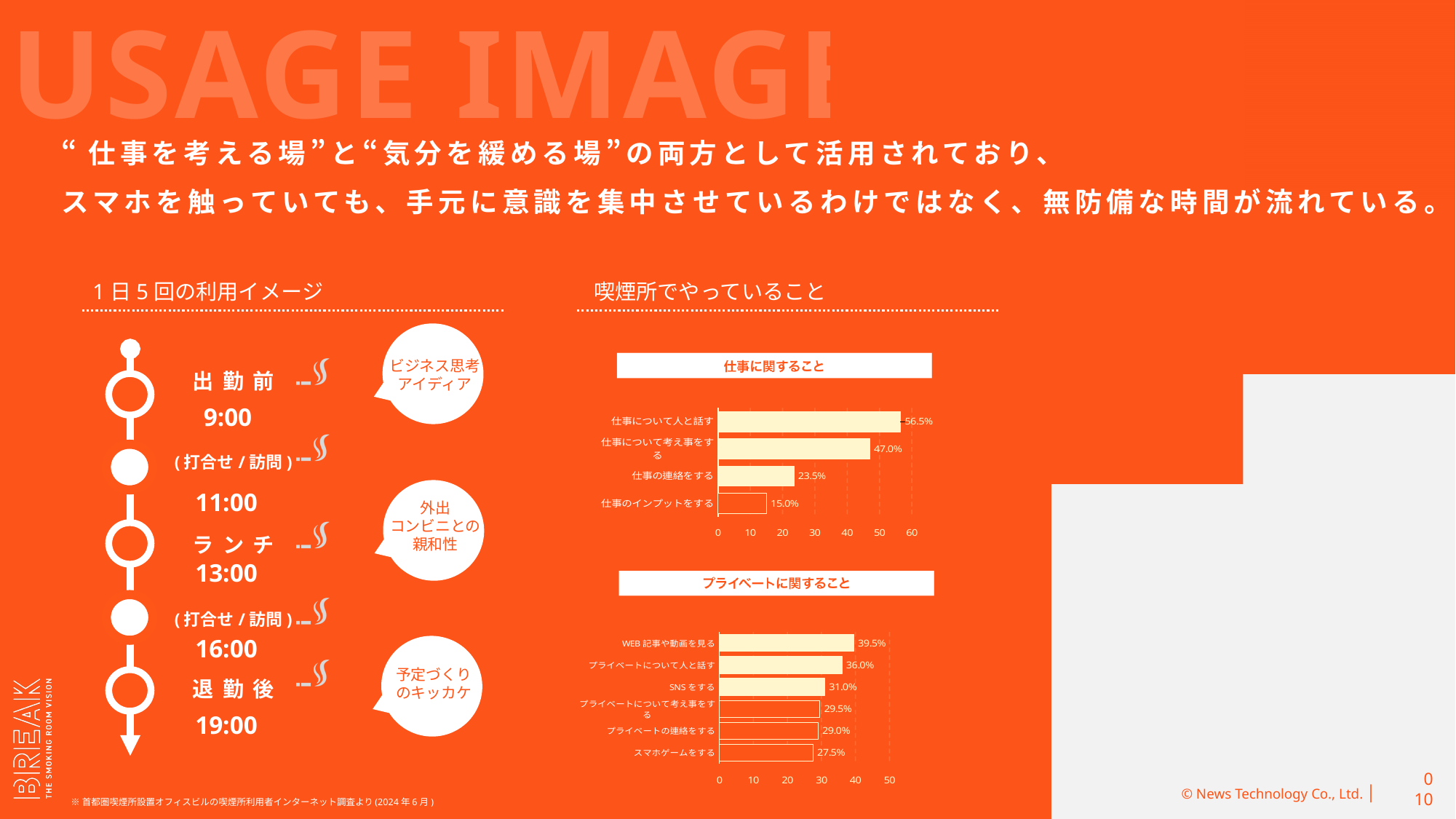
What type of chart is the 仕事に関すること chart? Bar chart In the 仕事に関すること chart, which category has the highest value? 仕事について人と話す In the プライベートに関すること chart, what is the value for SNSをする? 31.0% In the 仕事に関すること chart, what is the value for 仕事のインプットをする? 15.0% In the 仕事に関すること chart, what is the value for 仕事について人と話す? 56.5% In the 仕事に関すること chart, what is the difference between 仕事について考え事をする and 仕事の連絡をする? 23.5% In the プライベートに関すること chart, which category has the lowest value? スマホゲームをする In the プライベートに関すること chart, what is the difference between WEB記事や動画を見る and SNSをする? 8.5% In the プライベートに関すること chart, how many categories are shown? 6 In the プライベートに関すること chart, which is larger: WEB記事や動画を見る or プライベートについて人と話す? WEB記事や動画を見る In the プライベートに関すること chart, what is the value for スマホゲームをする? 27.5% In the 仕事に関すること chart, how many categories are shown? 4